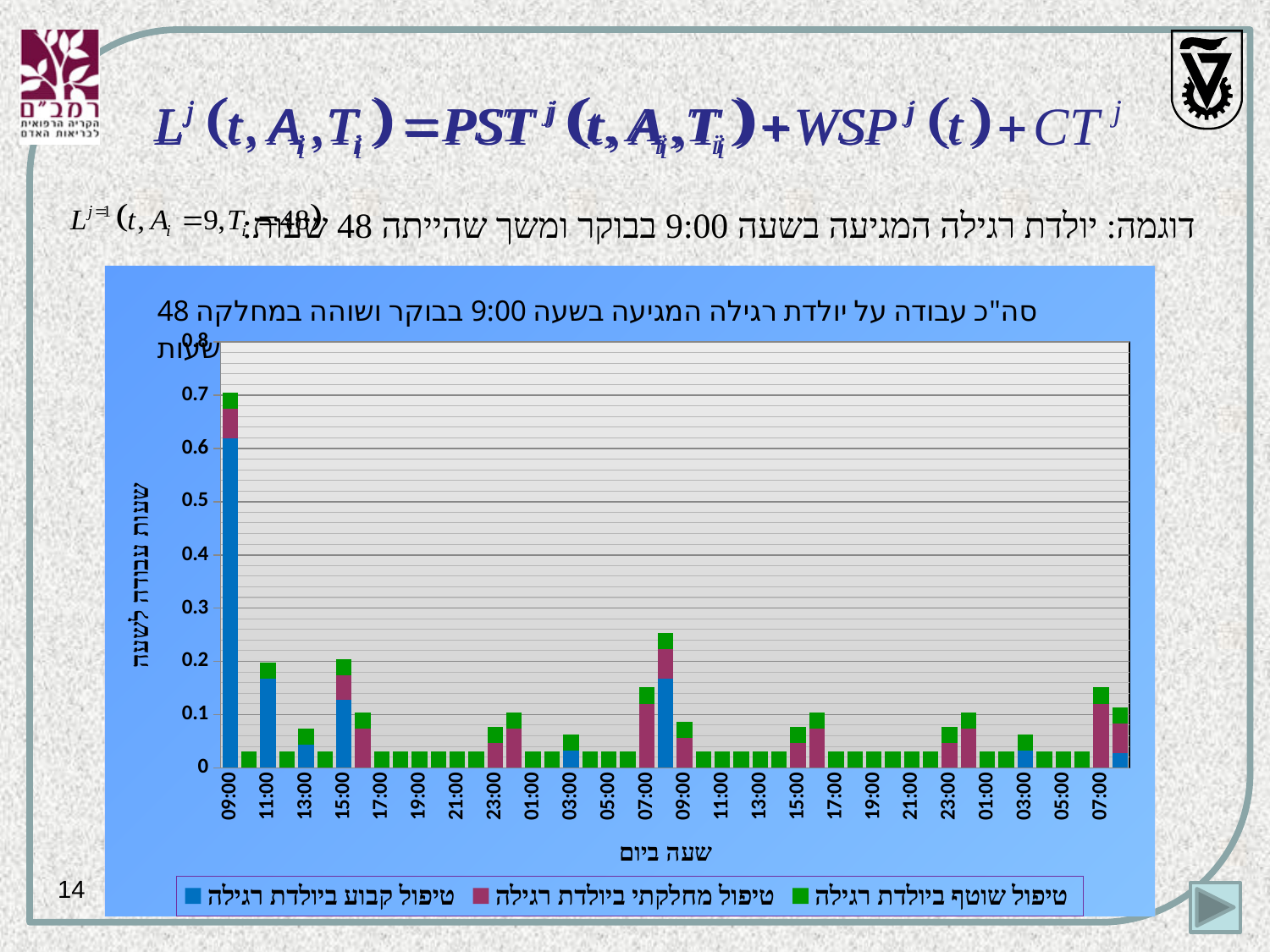
Is the total value of the tallest bar near 08:00 on the second day greater or less than 0.2? greater Is the total value of the first bar (09:00) greater or less than 0.6? greater How many series does the legend list? 3 Is the total value of the first bar (09:00) greater or less than 0.8? less What kind of chart is shown on the slide? stacked bar chart What is the label of the y axis? שעות עבודה לשעה Which series is shown in green in the legend? טיפול שוטף ביולדת רגילה Which bar is taller: the one at 09:00 on the first day or the one at 15:00 on the first day? 09:00 on the first day What is the highest value shown on the y axis? 0.8 At which hour of the day is the total stacked bar highest? 09:00 (the first bar)